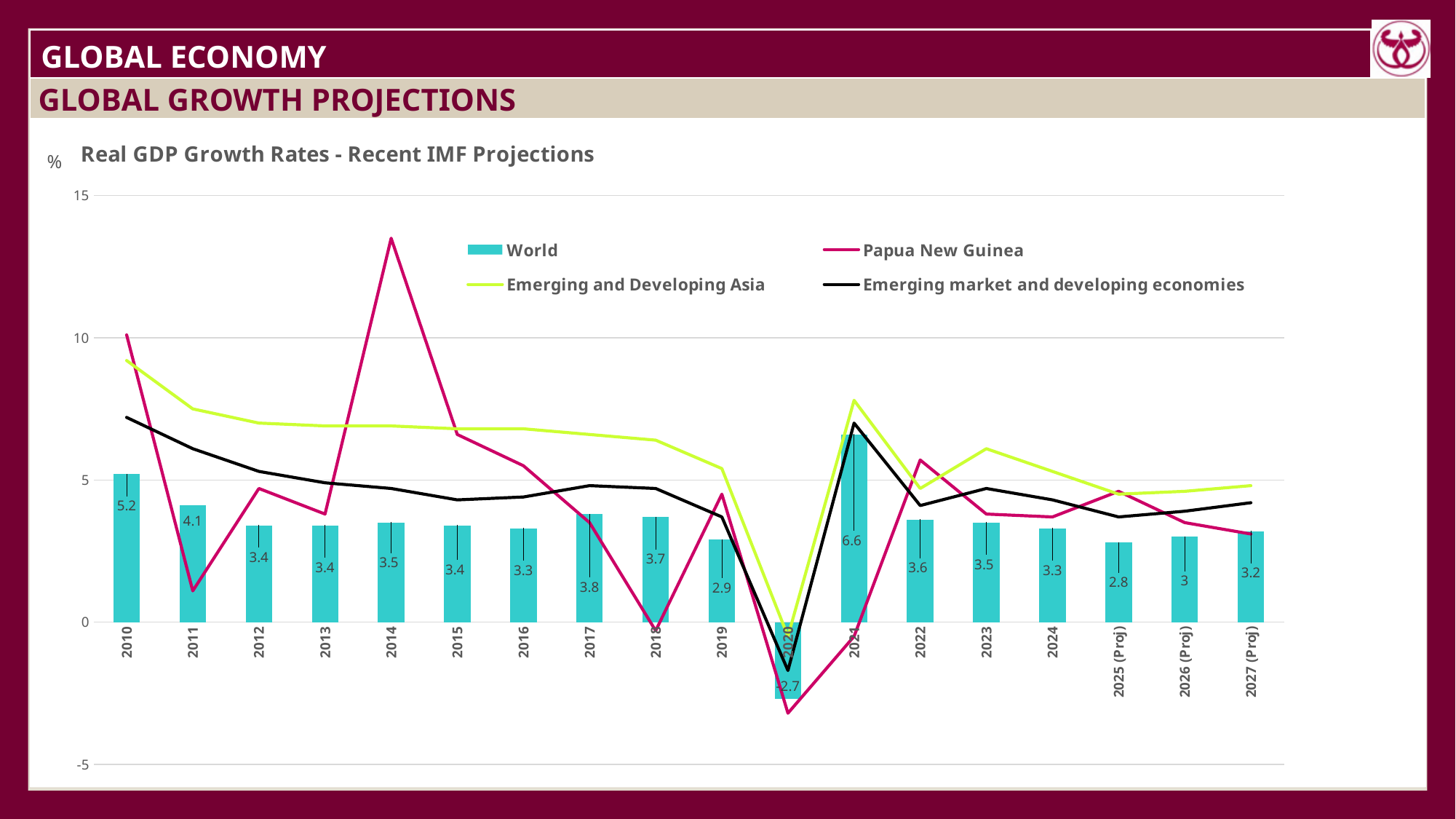
What is the difference between the World growth rate in 2021 and in 2020? 9.3 Is the Emerging and Developing Asia value for 2010 greater or less than 5? greater What is the World growth rate for 2020? -2.7 How many series does the legend list? 4 Is the Papua New Guinea value for 2014 greater or less than 10? greater What is the World growth rate for 2021? 6.6 How many years are shown on the x axis? 18 In which year is the World growth rate highest? 2021 In which year is the World growth rate lowest? 2020 Which year has a higher World growth rate, 2010 or 2011? 2010 What is the title of the chart? Real GDP Growth Rates - Recent IMF Projections What is the World growth rate projected for 2025 (Proj)? 2.8